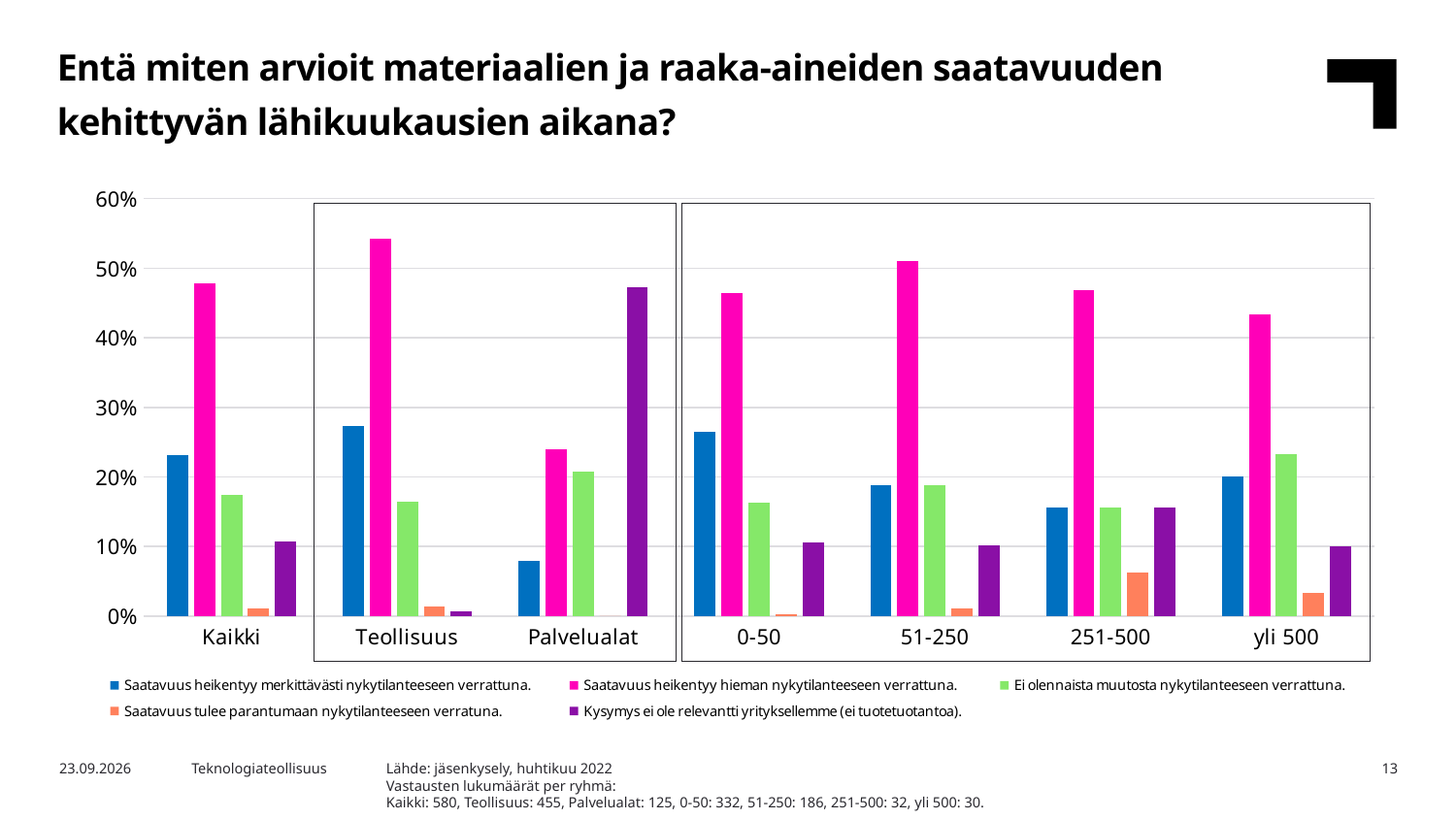
In the Palvelualat category, which is larger: 'Saatavuus heikentyy hieman nykytilanteeseen verrattuna' or 'Kysymys ei ole relevantti yrityksellemme (ei tuotetuotantoa)'? Kysymys ei ole relevantti yrityksellemme (ei tuotetuotantoa) Is the value for 'Saatavuus heikentyy merkittävästi nykytilanteeseen verrattuna' in the Teollisuus category greater or less than 30%? less Which category has the highest value for 'Saatavuus heikentyy hieman nykytilanteeseen verrattuna'? Teollisuus Is the value for 'Kysymys ei ole relevantti yrityksellemme (ei tuotetuotantoa)' in the Palvelualat category greater or less than 40%? greater Is the value for 'Saatavuus heikentyy hieman nykytilanteeseen verrattuna' in the Kaikki category greater or less than 40%? greater What colour represents 'Kysymys ei ole relevantti yrityksellemme (ei tuotetuotantoa)' in the legend? Purple What kind of chart is shown on the slide? Bar chart In the Kaikki category, which is larger: 'Saatavuus heikentyy merkittävästi nykytilanteeseen verrattuna' or 'Ei olennaista muutosta nykytilanteeseen verrattuna'? Saatavuus heikentyy merkittävästi nykytilanteeseen verrattuna Which category has the lowest value for 'Saatavuus heikentyy merkittävästi nykytilanteeseen verrattuna'? Palvelualat How many series does the legend list? 5 How many categories are shown on the x axis of the chart? 7